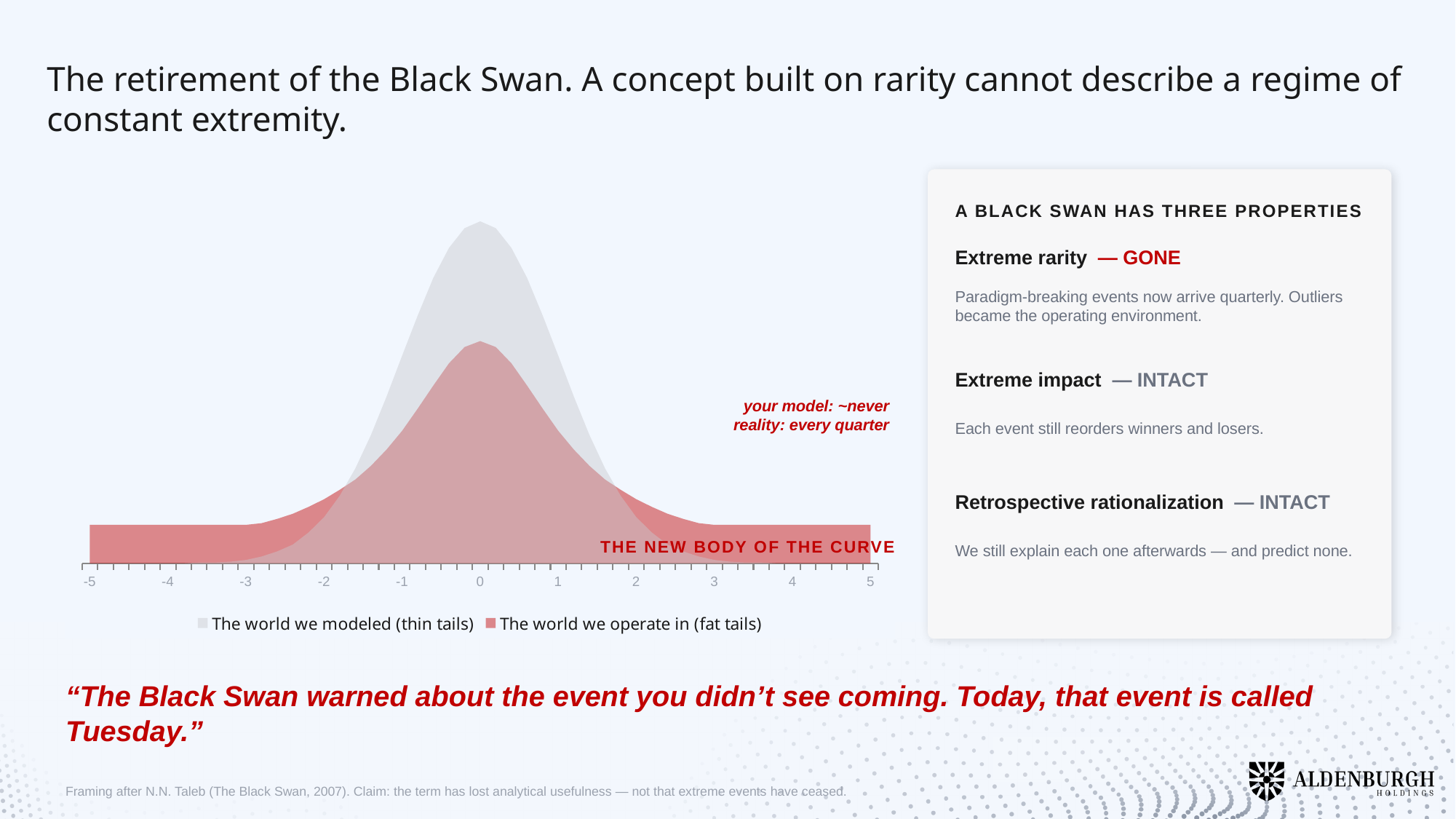
How many series does the chart legend list? 2 What is the highest value labelled on the chart's x axis? 5 At x = 5, which series has the higher value: 'The world we modeled (thin tails)' or 'The world we operate in (fat tails)'? The world we operate in (fat tails) At x = -4, which series is higher: the grey series or the red series? The red series (The world we operate in (fat tails)) Does the grey 'thin tails' series rise or fall as x moves from 0 to 5? Fall What are the two series named in the chart legend? The world we modeled (thin tails); The world we operate in (fat tails) What is the lowest value labelled on the chart's x axis? -5 How many labelled tick values are shown on the chart's x axis? 11 What kind of chart is shown on the slide? Area chart At x = 0, which series has the higher peak: 'The world we modeled (thin tails)' or 'The world we operate in (fat tails)'? The world we modeled (thin tails) Does the red 'fat tails' series rise or fall as x moves from -5 to 0? Rise